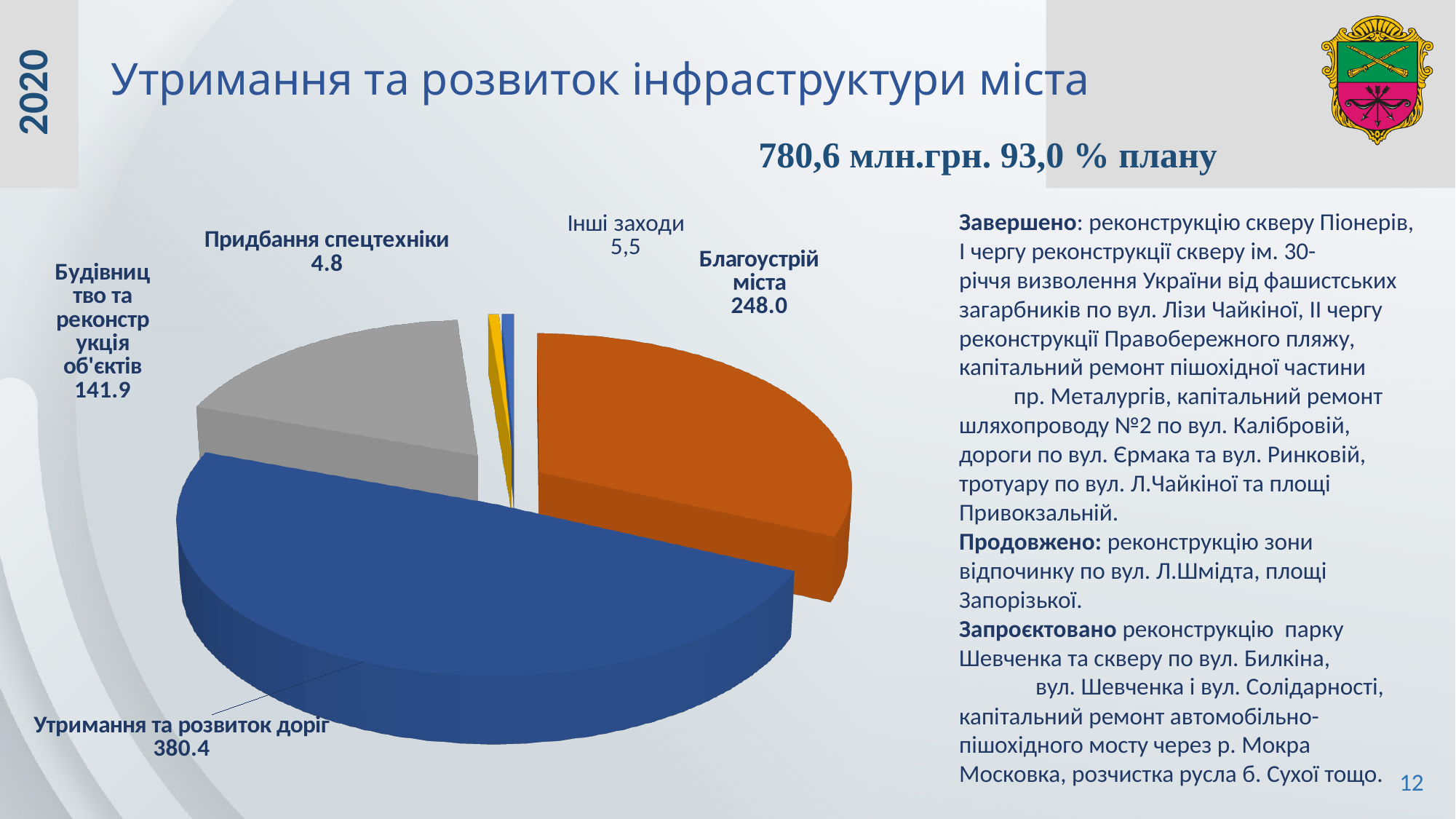
What is the value for Інші заходи? 5,5 What is the value for Благоустрій міста? 248.0 What is the value for Утримання та розвиток доріг? 380.4 Which category has the smallest slice of the pie? Придбання спецтехніки What total amount and percentage of plan is stated above the chart? 780,6 млн.грн. 93,0 % плану Which is larger, Інші заходи or Придбання спецтехніки? Інші заходи What is the value for Будівництво та реконструкція об'єктів? 141.9 How many slices does the pie chart have? 5 What is the difference between Утримання та розвиток доріг and Благоустрій міста? 132.4 Which category has the largest slice of the pie? Утримання та розвиток доріг What is the total of all slices in the pie chart? 780.6 What kind of chart is shown on the slide? pie chart